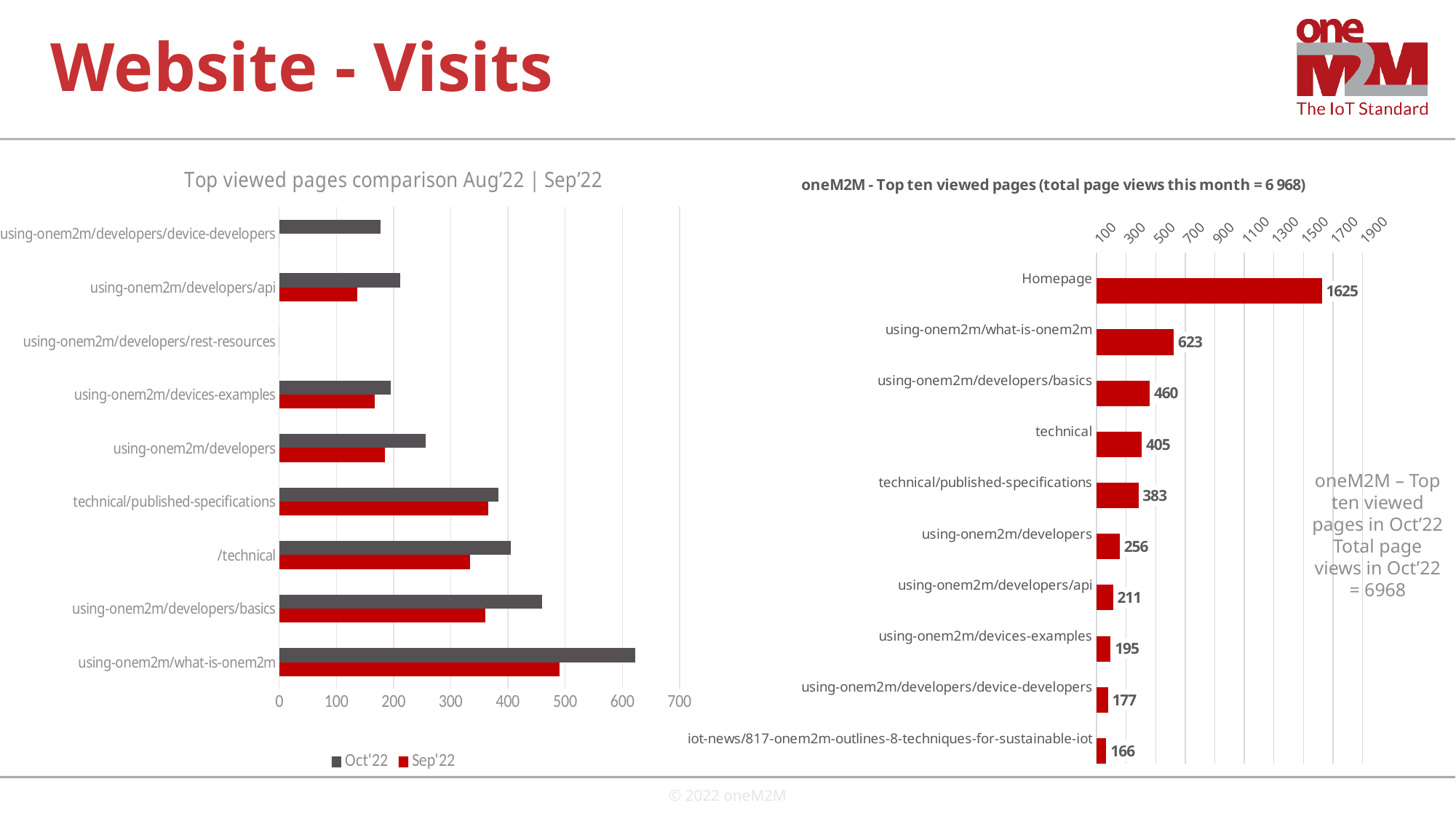
How many pages are shown in the right chart 'oneM2M - Top ten viewed pages'? 10 In the left chart 'Top viewed pages comparison', is the Sep'22 value for using-onem2m/developers/api greater or less than 200? less In the right chart 'oneM2M - Top ten viewed pages', which page has the lowest value? iot-news/817-onem2m-outlines-8-techniques-for-sustainable-iot In the right chart 'oneM2M - Top ten viewed pages', what is the value for Homepage? 1625 How many series does the legend of the left chart 'Top viewed pages comparison' list? 2 In the right chart 'oneM2M - Top ten viewed pages', what is the difference between Homepage and using-onem2m/what-is-onem2m? 1002 In the right chart 'oneM2M - Top ten viewed pages', which is larger: technical or technical/published-specifications? technical In the right chart 'oneM2M - Top ten viewed pages', which page has the highest value? Homepage What kind of chart is the left chart 'Top viewed pages comparison'? bar chart In the right chart 'oneM2M - Top ten viewed pages', what is the value for using-onem2m/developers/basics? 460 In the left chart 'Top viewed pages comparison', is the Oct'22 value for using-onem2m/what-is-onem2m greater or less than 600? greater In the right chart 'oneM2M - Top ten viewed pages', what is the value for iot-news/817-onem2m-outlines-8-techniques-for-sustainable-iot? 166